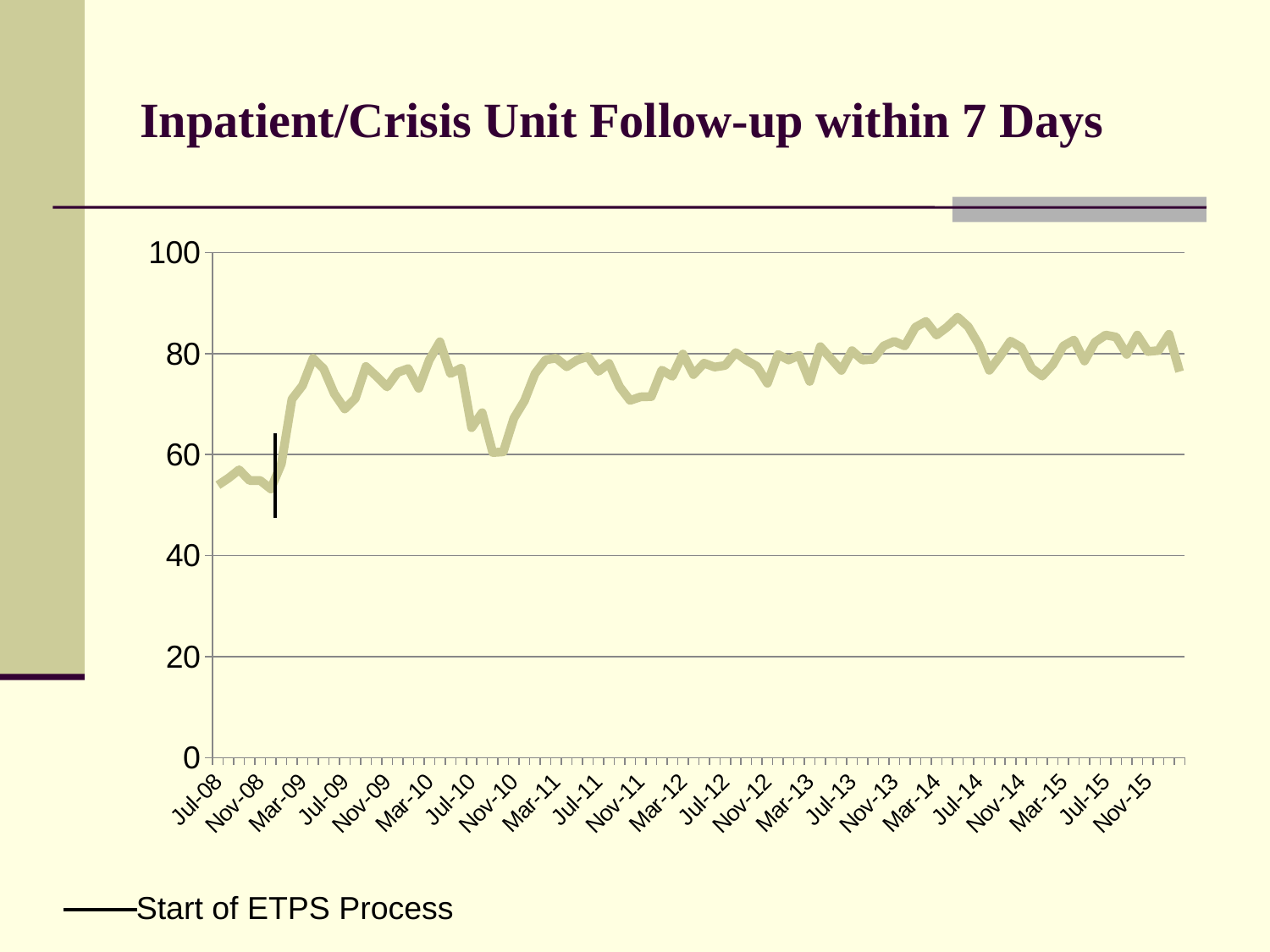
What is the title of the chart? Inpatient/Crisis Unit Follow-up within 7 Days Overall, does the line rise or fall from Jul-08 to Nov-15? rise Is the value for Nov-11 greater or less than 80? less Is the value for Mar-14 greater or less than 80? greater How many month labels are printed along the x axis? 23 Is the value for Mar-09 greater or less than 60? greater What kind of chart is shown on the slide? line chart Which is larger, the value for Jul-08 or the value for Mar-14? Mar-14 What entry does the legend below the chart list? Start of ETPS Process